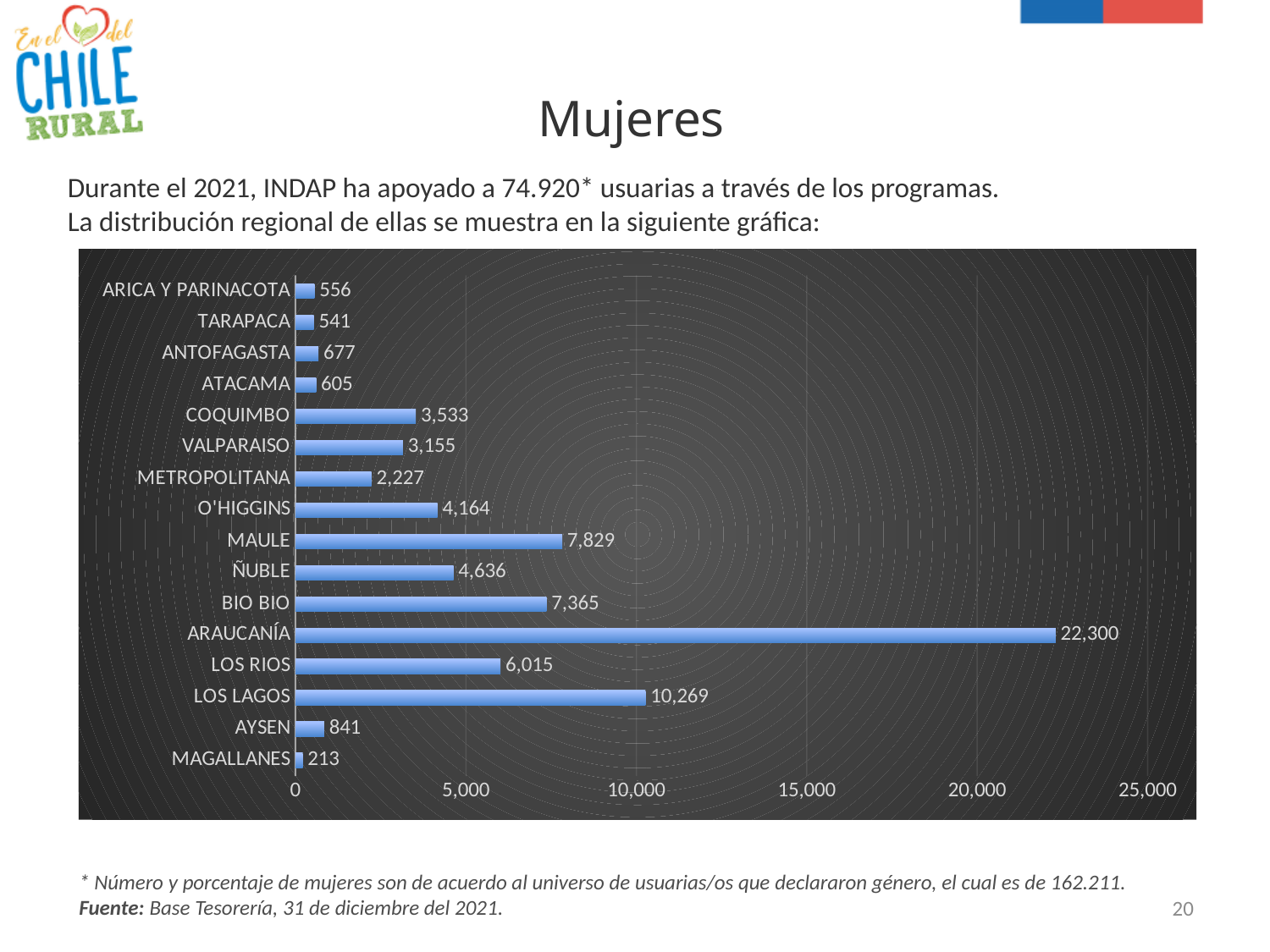
What kind of chart is shown on the slide? bar chart What is the value for ARAUCANÍA? 22,300 How many regions are shown in the chart? 16 Which region has the lowest value? MAGALLANES What is the value for METROPOLITANA? 2,227 Which has a larger value, COQUIMBO or VALPARAISO? COQUIMBO Is the value for LOS LAGOS greater or less than 10,000? greater What is the difference between the values for MAULE and BIO BIO? 464 What is the value for MAGALLANES? 213 What is the value for LOS LAGOS? 10,269 Which region has the highest value? ARAUCANÍA What is the difference between the values for ARAUCANÍA and LOS LAGOS? 12,031